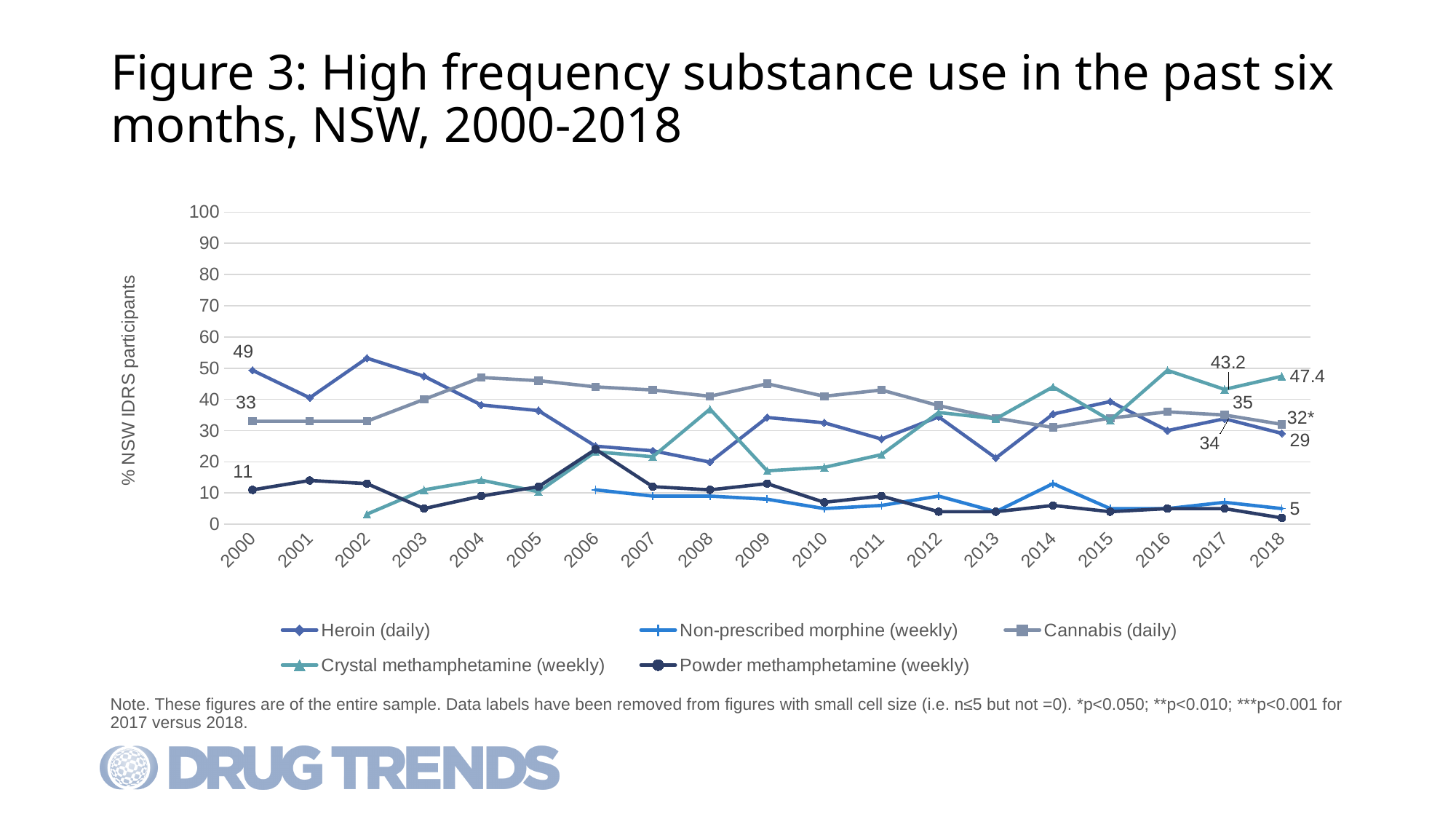
How many series does the legend list? 5 Is the value for Heroin (daily) in 2002 greater or less than 50? greater What kind of chart is shown on the slide? Line chart How many years are shown on the x axis? 19 By how much did the value for Heroin (daily) fall between 2000 and 2018? 20 What was the value for Heroin (daily) in 2018? 29 What was the value for Heroin (daily) in 2000? 49 What was the value for Powder methamphetamine (weekly) in 2000? 11 Which series had the highest value in 2018? Crystal methamphetamine (weekly) What was the value for Non-prescribed morphine (weekly) in 2018? 5 What was the value for Crystal methamphetamine (weekly) in 2018? 47.4 What was the value for Cannabis (daily) in 2000? 33